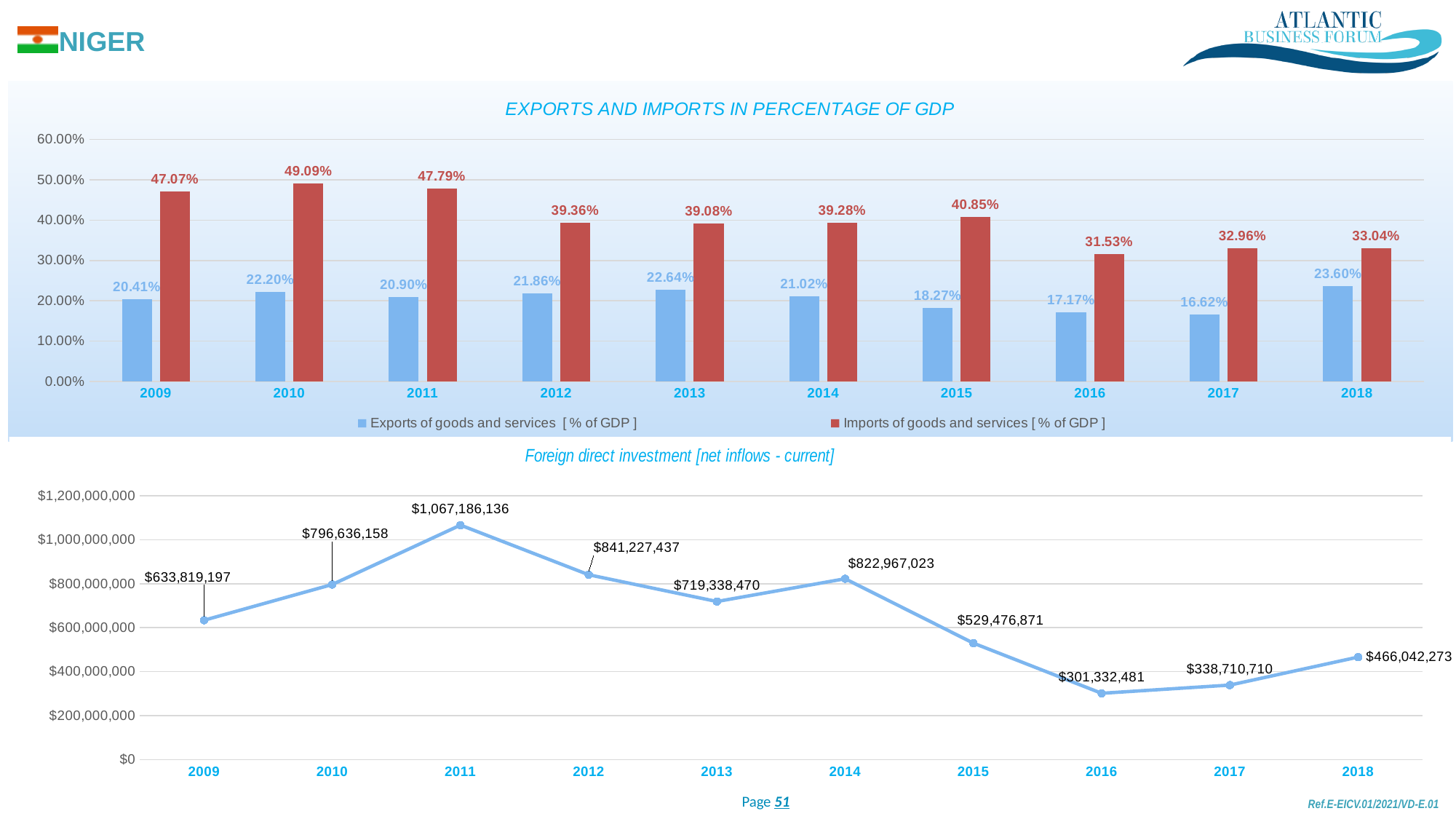
In the 'Foreign direct investment [net inflows - current]' chart, what is the value for 2011? $1,067,186,136 In the 'Exports and Imports in Percentage of GDP' chart, which year has the lowest value for Imports of goods and services? 2016 In the 'Exports and Imports in Percentage of GDP' chart, what is the value for Imports of goods and services in 2010? 49.09% What kind of chart is the 'Exports and Imports in Percentage of GDP' chart? Bar chart In the 'Exports and Imports in Percentage of GDP' chart, what is the difference between Imports and Exports in 2015? 22.58% In the 'Foreign direct investment [net inflows - current]' chart, which year has the lowest value? 2016 In the 'Foreign direct investment [net inflows - current]' chart, is the value for 2014 larger than the value for 2013? Yes In the 'Foreign direct investment [net inflows - current]' chart, how many years are plotted? 10 In the 'Exports and Imports in Percentage of GDP' chart, how many series does the legend list? 2 What kind of chart is the 'Foreign direct investment [net inflows - current]' chart? Line chart In the 'Exports and Imports in Percentage of GDP' chart, what is the value for Exports of goods and services in 2017? 16.62% In the 'Exports and Imports in Percentage of GDP' chart, which year has the highest value for Exports of goods and services? 2018